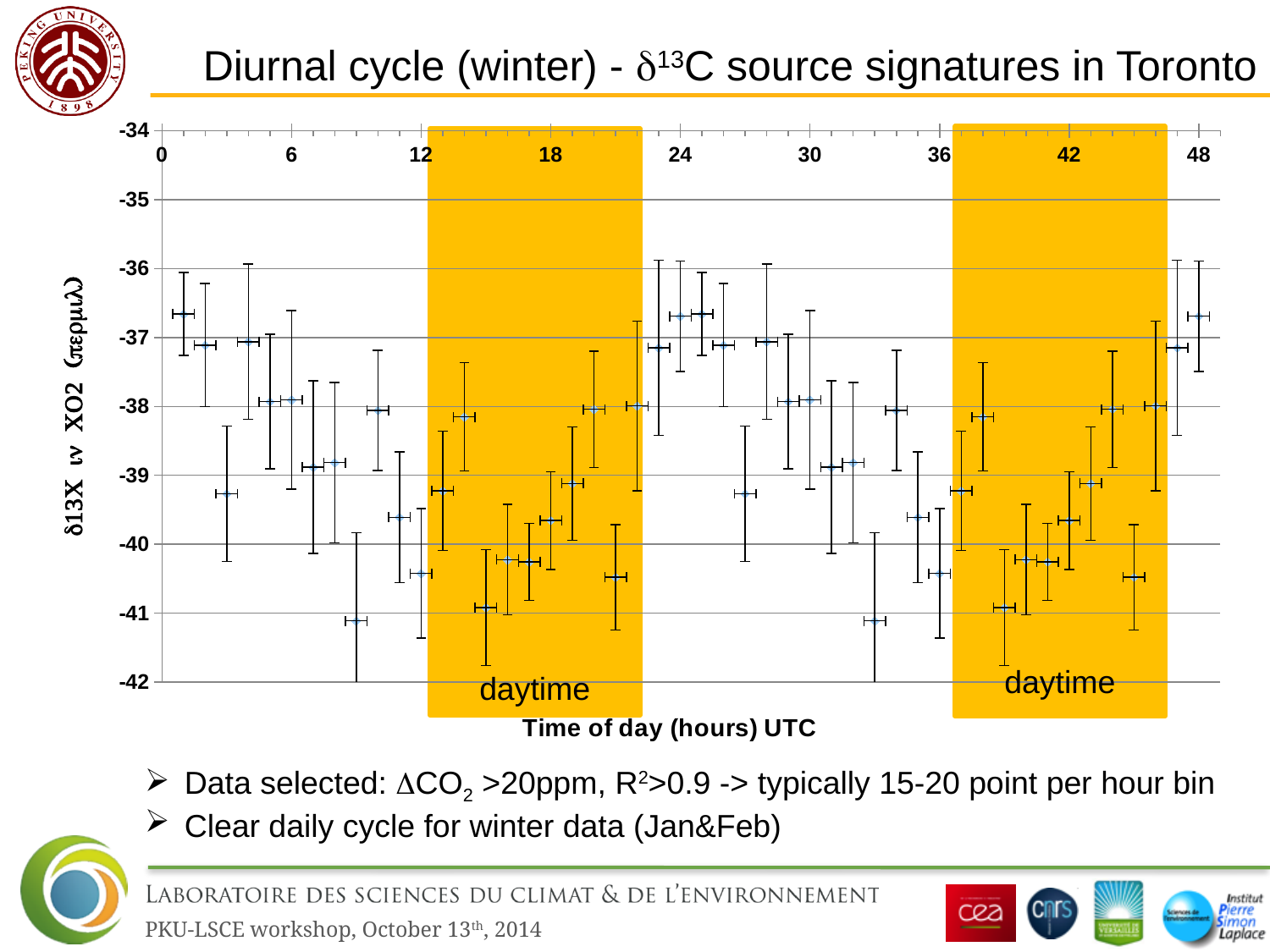
Is the value at hour 33 greater or less than -40? less What kind of chart is shown on the slide? Scatter plot with error bars Do the values generally rise or fall between hour 0 and hour 15? fall Which is larger, the value at hour 33 or the value at hour 36? hour 36 Is the value at hour 15 greater or less than -40? less Is the value at hour 24 greater or less than -37? greater What is the title of the x axis? Time of day (hours) UTC What label is written inside the two orange shaded regions? daytime Do the values generally rise or fall between hour 15 and hour 24? rise Which is larger, the value at hour 1 or the value at hour 9? hour 1